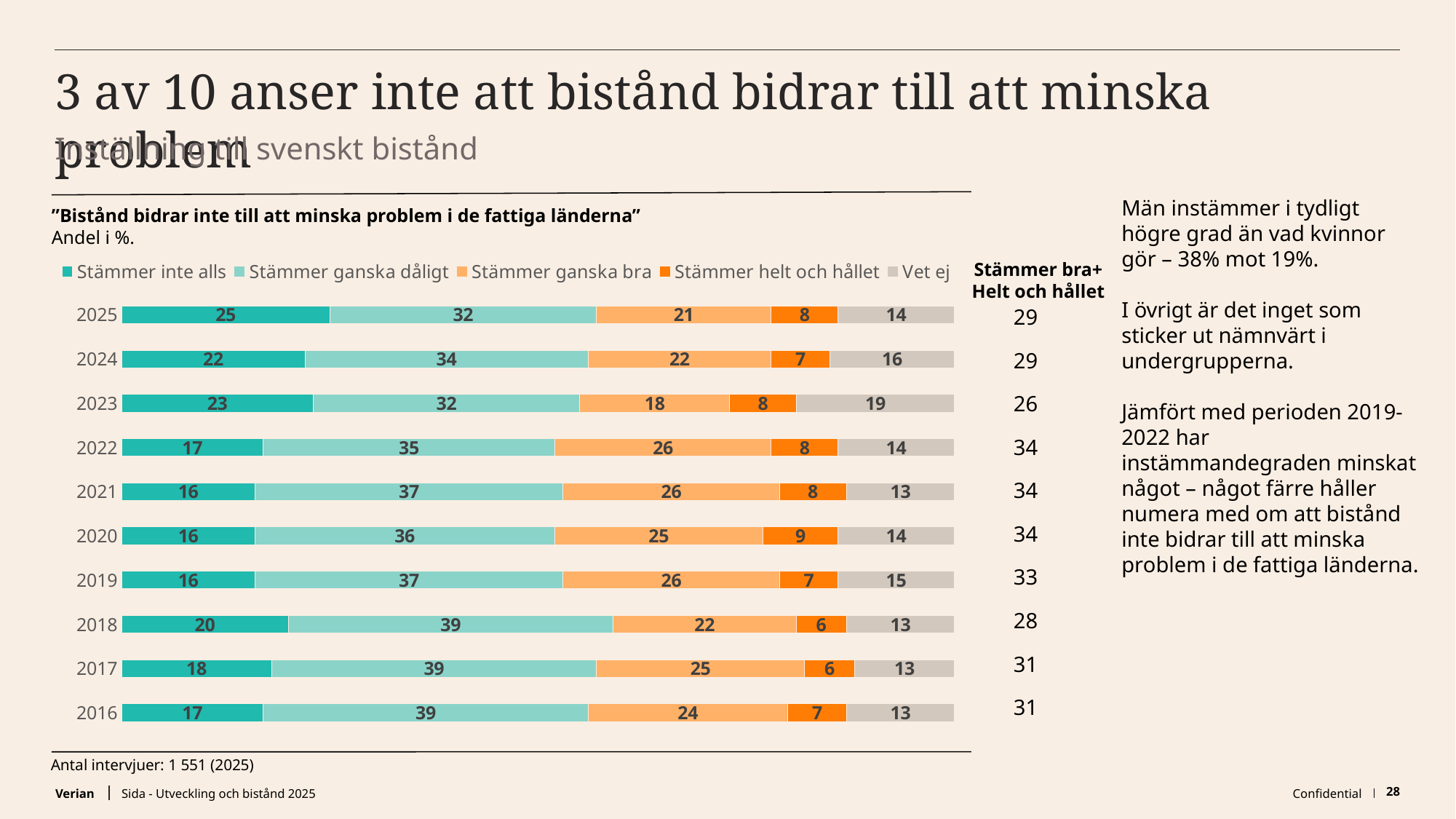
Which year has the lowest "Stämmer ganska bra" value? 2023 How many series does the legend list? 5 Which year has the highest "Stämmer inte alls" value? 2025 What percentage answered "Stämmer inte alls" in 2025? 25 What is the "Stämmer ganska bra" value for 2022? 26 What kind of chart is shown on the slide? Stacked bar chart How many years are shown in the chart? 10 Which year has the highest "Stämmer helt och hållet" value? 2020 What is the difference between the "Stämmer inte alls" values for 2025 and 2024? 3 Which year has the highest "Vet ej" value? 2023 What is the "Vet ej" value for 2023? 19 Which is larger: the "Stämmer ganska dåligt" value for 2018 or for 2025? 2018